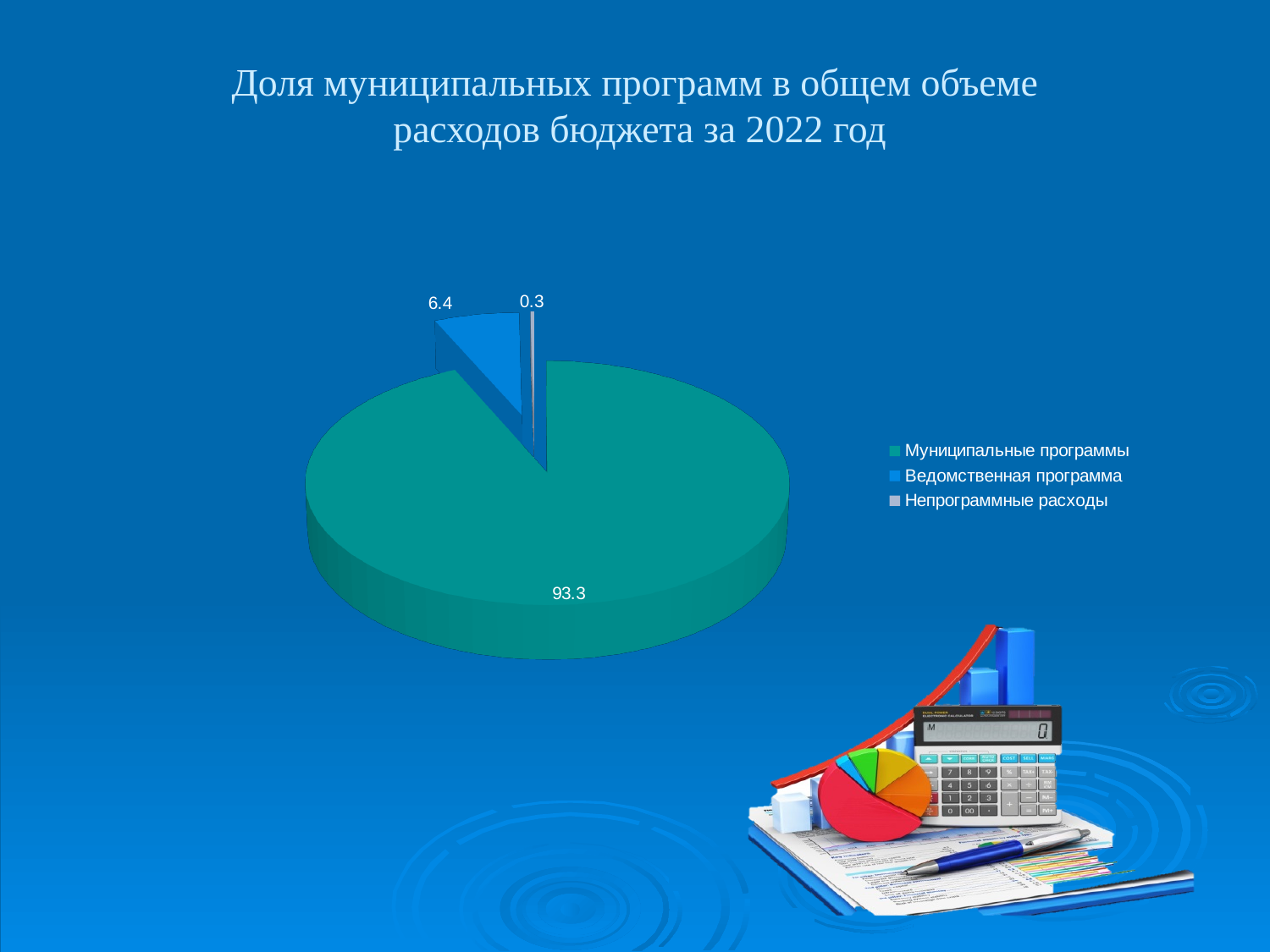
What is the value for Ведомственная программа? 6.4 Which category has the smallest slice of the pie? Непрограммные расходы What is the value for Непрограммные расходы? 0.3 How many slices does the pie chart have? 3 What is the difference between the values for Ведомственная программа and Непрограммные расходы? 6.1 What is the value for Муниципальные программы? 93.3 Which category has the largest slice of the pie? Муниципальные программы How many entries does the legend list? 3 What is the difference between the values for Муниципальные программы and Ведомственная программа? 86.9 Which is larger, the value for Ведомственная программа or the value for Непрограммные расходы? Ведомственная программа What is the title of the chart on the slide? Доля муниципальных программ в общем объеме расходов бюджета за 2022 год What kind of chart is shown on the slide? Pie chart